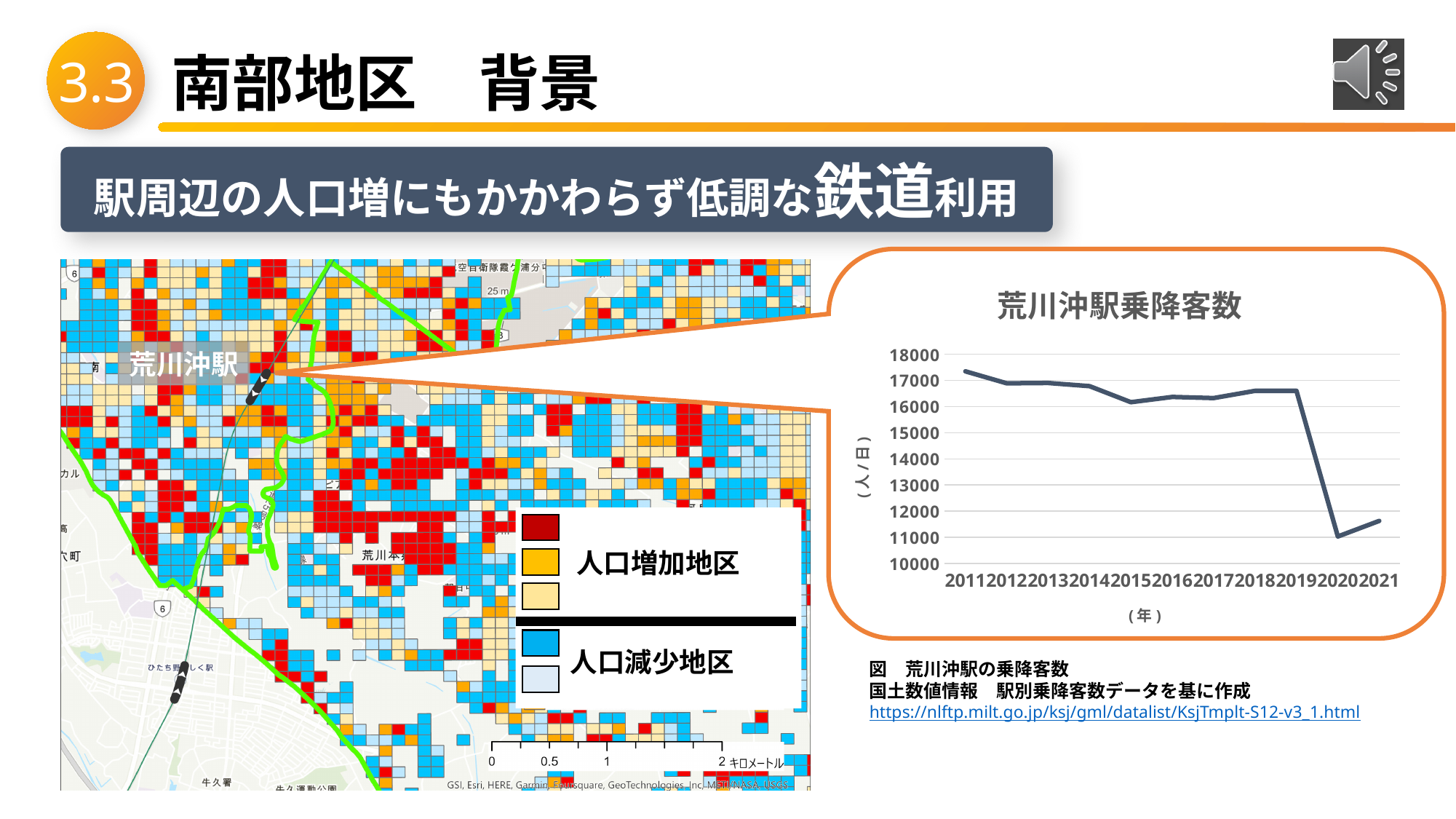
In the 荒川沖駅乗降客数 chart, is the value for 2015 greater or less than 17000? less In the 荒川沖駅乗降客数 chart, is the value for 2019 greater or less than 16000? greater How many years are plotted on the x axis of the 荒川沖駅乗降客数 chart? 11 In the 荒川沖駅乗降客数 chart, is the value for 2020 greater or less than 12000? less In the 荒川沖駅乗降客数 chart, do the values overall rise or fall from 2011 to 2021? fall What unit label is shown on the y axis of the 荒川沖駅乗降客数 chart? （人/日） In the 荒川沖駅乗降客数 chart, which year has the lowest value? 2020 In the 荒川沖駅乗降客数 chart, which year has the highest value? 2011 What is the title of the chart on the right side of the slide? 荒川沖駅乗降客数 In the 荒川沖駅乗降客数 chart, which year has the larger value, 2020 or 2021? 2021 What kind of chart is shown on the right side of the slide? line chart